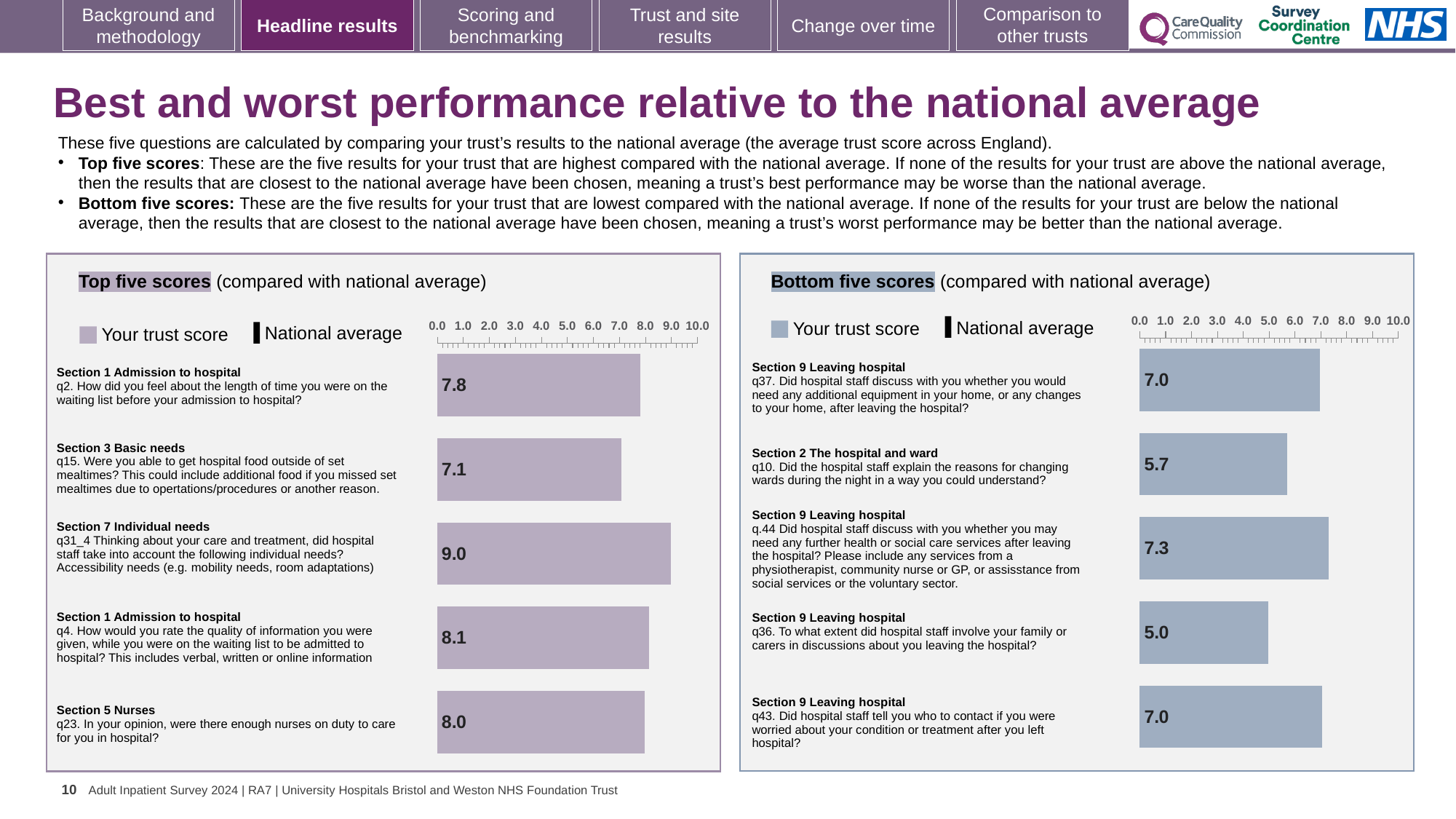
What type of chart is used for the Top five scores? Bar chart In the Top five scores chart, which question has the lowest trust score? q15 (Section 3 Basic needs) In the Bottom five scores chart, what is the trust score for q10 about explaining reasons for changing wards during the night? 5.7 In the Bottom five scores chart, which question has the lowest trust score? q36 (Section 9 Leaving hospital) In the Bottom five scores chart, which question has the highest trust score? q.44 (Section 9 Leaving hospital) In the Top five scores chart, what is the trust score for q31_4 about accessibility needs? 9.0 How many bars are plotted in the Bottom five scores chart? 5 In the Top five scores chart, what is the trust score for q2 about the length of time on the waiting list before admission? 7.8 In the Top five scores chart, what is the difference between the trust scores for q4 and q23? 0.1 In the Bottom five scores chart, what is the difference between the trust scores for q.44 and q36? 2.3 In the Top five scores chart, which question has the highest trust score? q31_4 (Section 7 Individual needs) Which is larger: the trust score for q2 in the Top five scores chart or the trust score for q.44 in the Bottom five scores chart? q2 in the Top five scores chart (7.8)